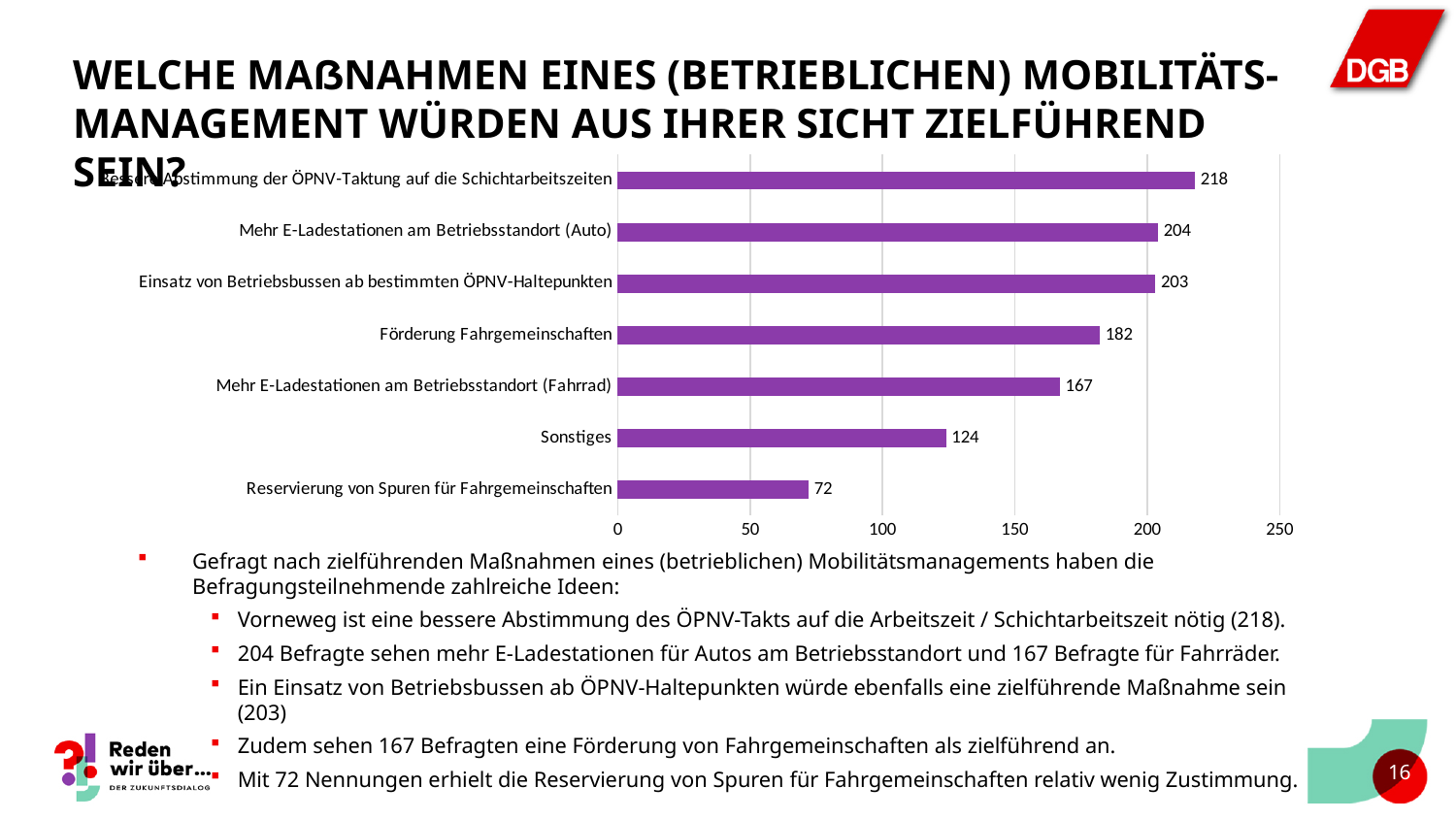
What value is shown for "Sonstiges"? 124 What value is shown for "Mehr E-Ladestationen am Betriebsstandort (Auto)"? 204 What kind of chart is shown on the slide? bar chart Which is larger: the value for "Förderung Fahrgemeinschaften" or the value for "Sonstiges"? Förderung Fahrgemeinschaften Is the value for "Reservierung von Spuren für Fahrgemeinschaften" greater or less than 100? less What value is shown for "Förderung Fahrgemeinschaften"? 182 What is the maximum value shown on the horizontal axis? 250 What is the difference between the values for "Mehr E-Ladestationen am Betriebsstandort (Auto)" and "Mehr E-Ladestationen am Betriebsstandort (Fahrrad)"? 37 How many categories are shown in the chart? 7 What is the highest value shown in the chart? 218 What value is shown for "Einsatz von Betriebsbussen ab bestimmten ÖPNV-Haltepunkten"? 203 Which category has the lowest value? Reservierung von Spuren für Fahrgemeinschaften